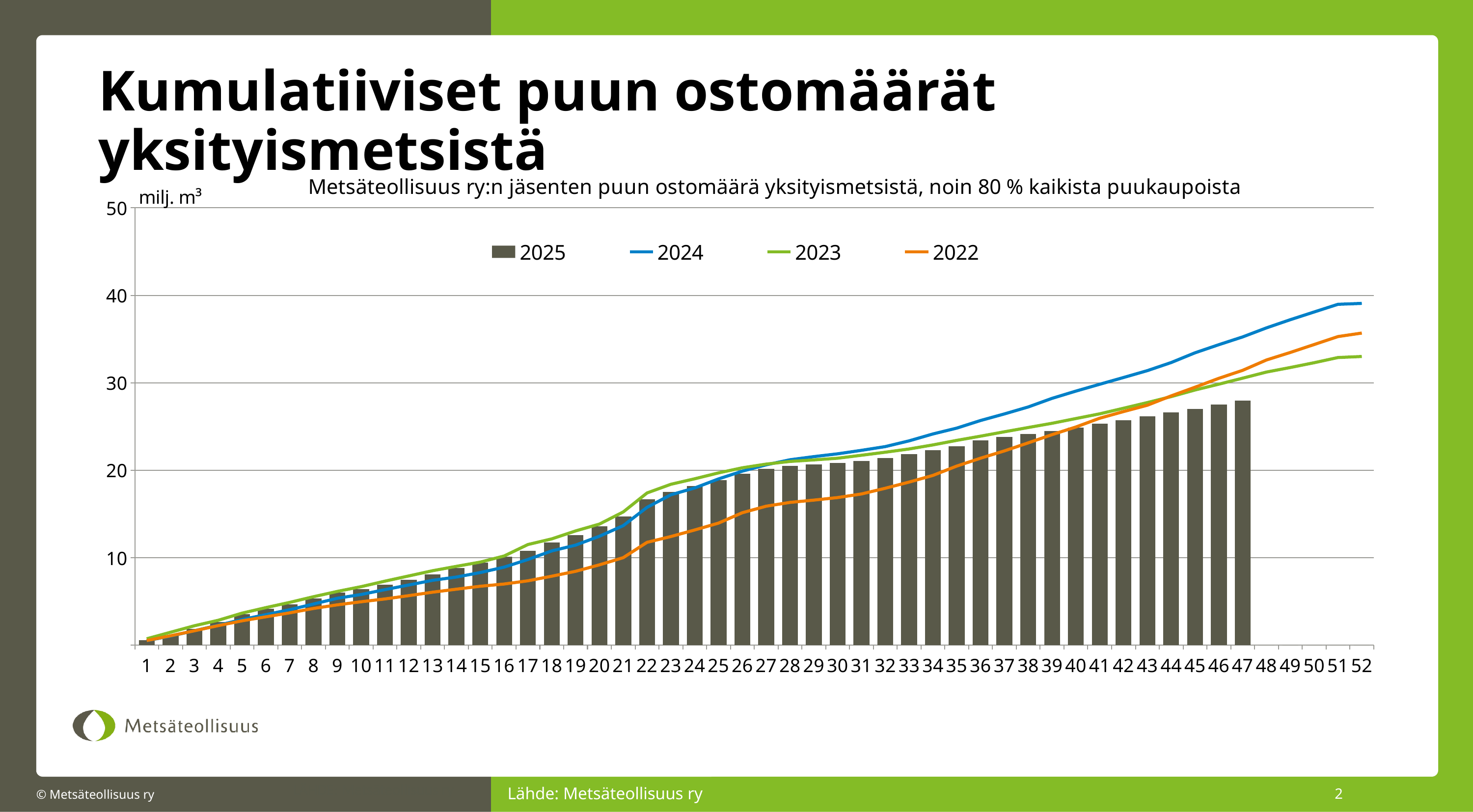
Do the values for each series rise or fall along the x axis? Rise Which series has the highest value at week 52? 2024 At week 52, which is larger: the 2022 value or the 2023 value? 2022 Is the 2024 value at week 52 greater or less than 30? greater What unit is shown on the y axis? milj. m³ What kind of chart is shown on the slide? A combination of a bar chart and line chart Which series is drawn as bars rather than a line? 2025 Which line series has the lowest value at week 30? 2022 How many series does the legend list? 4 Is the 2025 value at week 47 greater or less than 30? less Up to which week do the 2025 bars extend? 47 How many week categories are shown on the x axis? 52